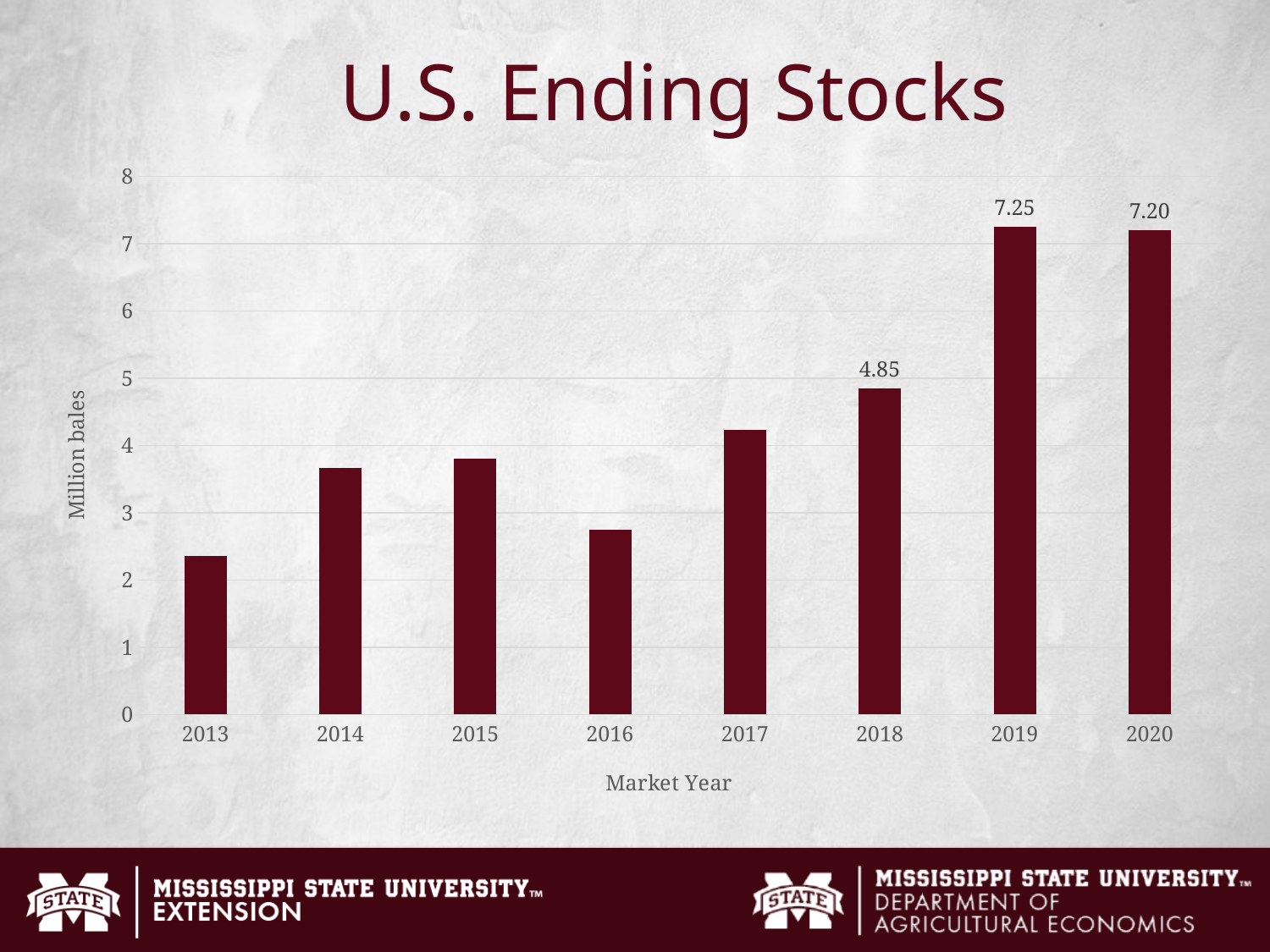
How many market years are shown on the chart? 8 What is the label on the vertical axis? Million bales Is the value for 2017 greater or less than 4? greater What is the value for 2020? 7.20 What is the difference between the values for 2019 and 2018? 2.40 Which market year has the highest ending stocks? 2019 What is the value for 2019? 7.25 Which is larger, the value for 2019 or the value for 2020? 2019 Which market year has the lowest ending stocks? 2013 What is the value for 2018? 4.85 What kind of chart is shown on the slide? bar chart Is the value for 2013 greater or less than 3? less